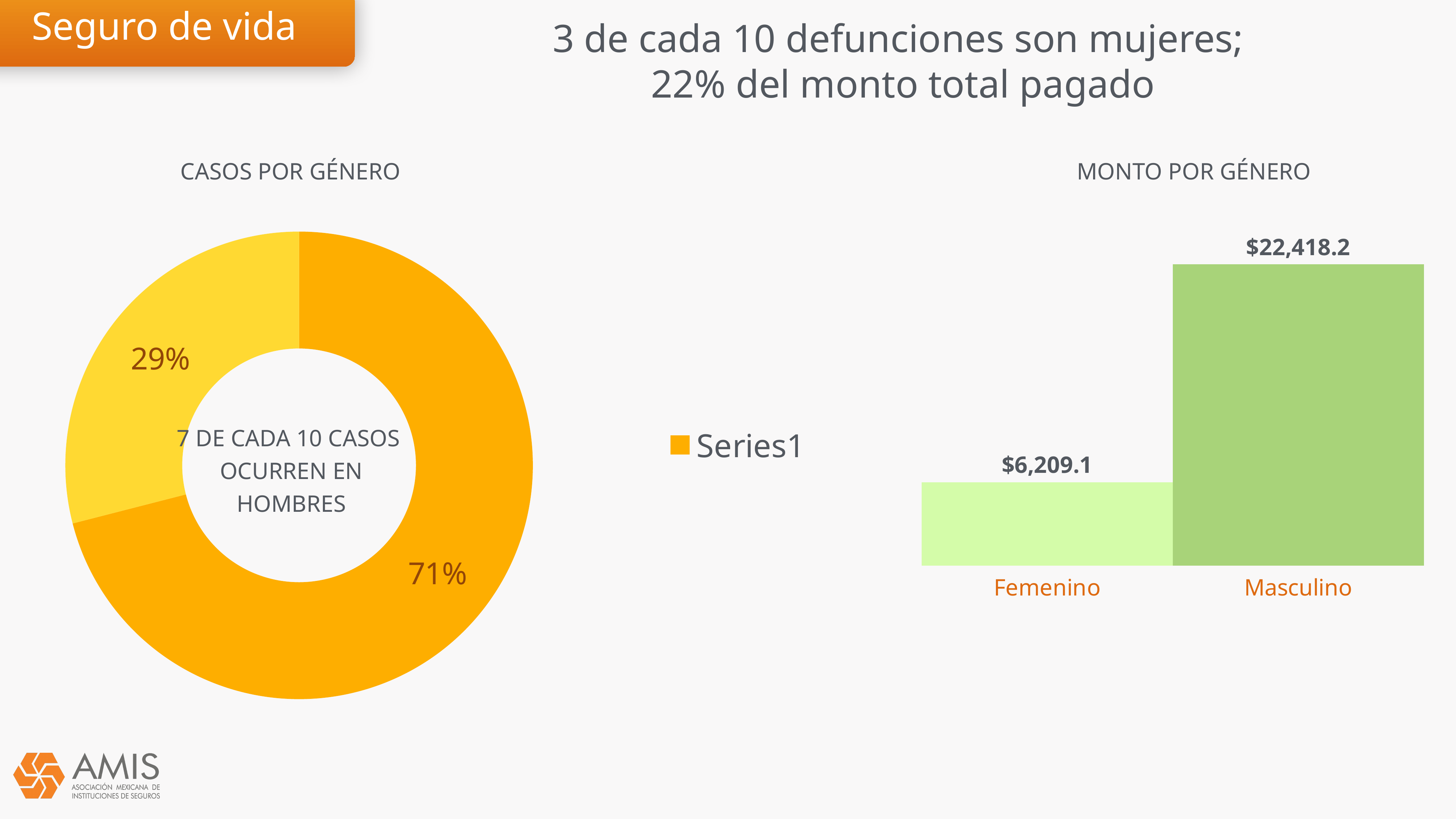
In the MONTO POR GÉNERO chart, what is the difference between the Masculino and Femenino values? $16,209.1 In the CASOS POR GÉNERO chart, what percentage does the larger slice show? 71% How many categories are shown in the MONTO POR GÉNERO chart? 2 In the MONTO POR GÉNERO chart, which category has the highest value? Masculino In the MONTO POR GÉNERO chart, is the value for Femenino larger or smaller than the value for Masculino? smaller In the MONTO POR GÉNERO chart, what is the value for Masculino? $22,418.2 What kind of chart is the CASOS POR GÉNERO chart? donut chart What text appears in the centre of the CASOS POR GÉNERO donut chart? 7 DE CADA 10 CASOS OCURREN EN HOMBRES In the MONTO POR GÉNERO chart, what is the value for Femenino? $6,209.1 In the CASOS POR GÉNERO chart, what percentage does the smaller slice show? 29% In the MONTO POR GÉNERO chart, which category has the lowest value? Femenino What kind of chart is the MONTO POR GÉNERO chart? bar chart